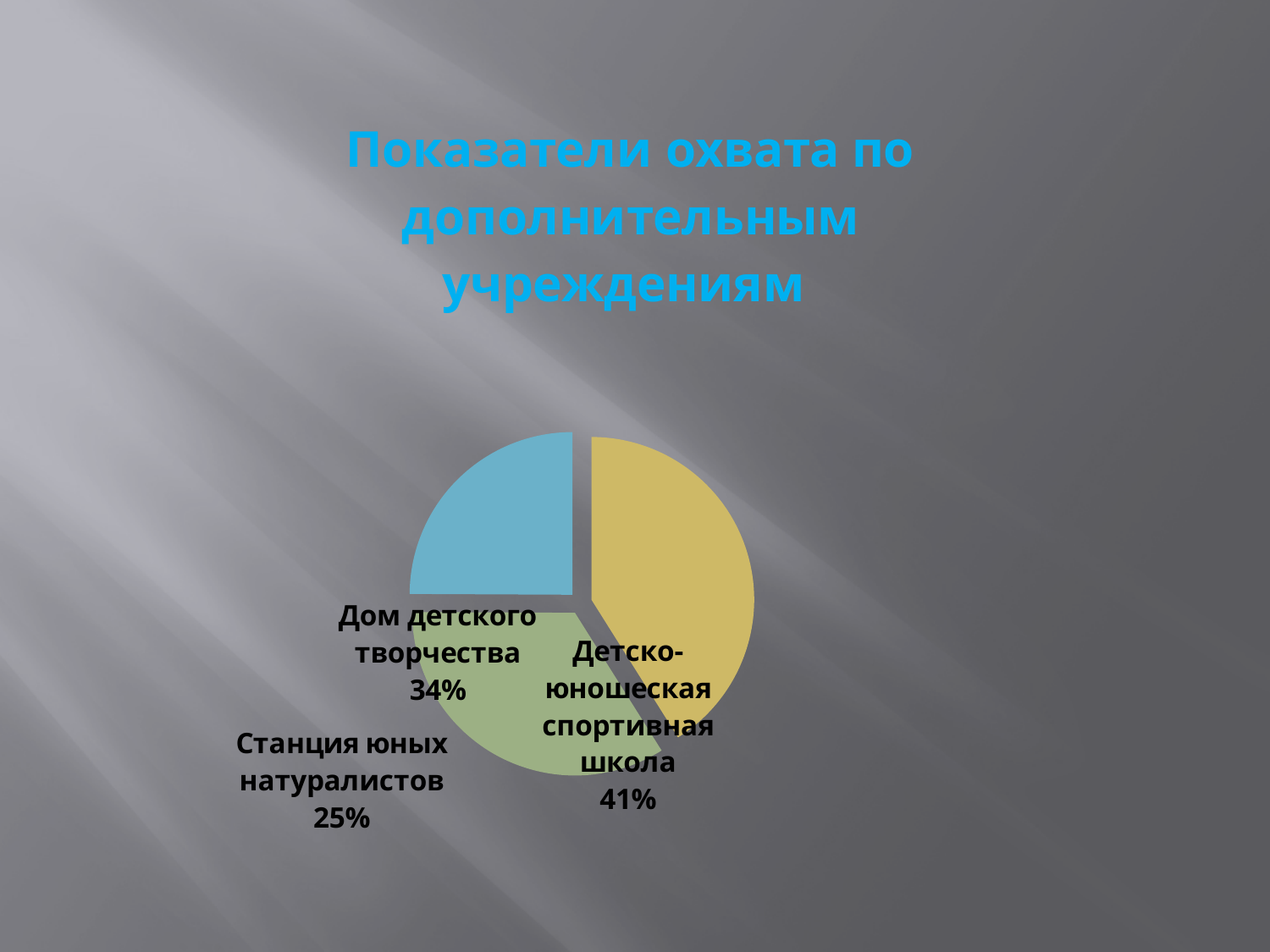
What is the difference in percentage points between Детско-юношеская спортивная школа and Станция юных натуралистов? 16 How many slices does the pie chart have? 3 What is the title of the chart? Показатели охвата по дополнительным учреждениям Which is larger: the share of Дом детского творчества or the share of Станция юных натуралистов? Дом детского творчества What share does Детско-юношеская спортивная школа have in the pie chart? 41% Which category has the largest share in the pie chart? Детско-юношеская спортивная школа What share does Дом детского творчества have in the pie chart? 34% Which category has the smallest share in the pie chart? Станция юных натуралистов What share does Станция юных натуралистов have in the pie chart? 25% What is the difference in percentage points between Детско-юношеская спортивная школа and Дом детского творчества? 7 Which category does the yellow slice of the pie chart represent? Детско-юношеская спортивная школа What type of chart is shown on the slide? pie chart